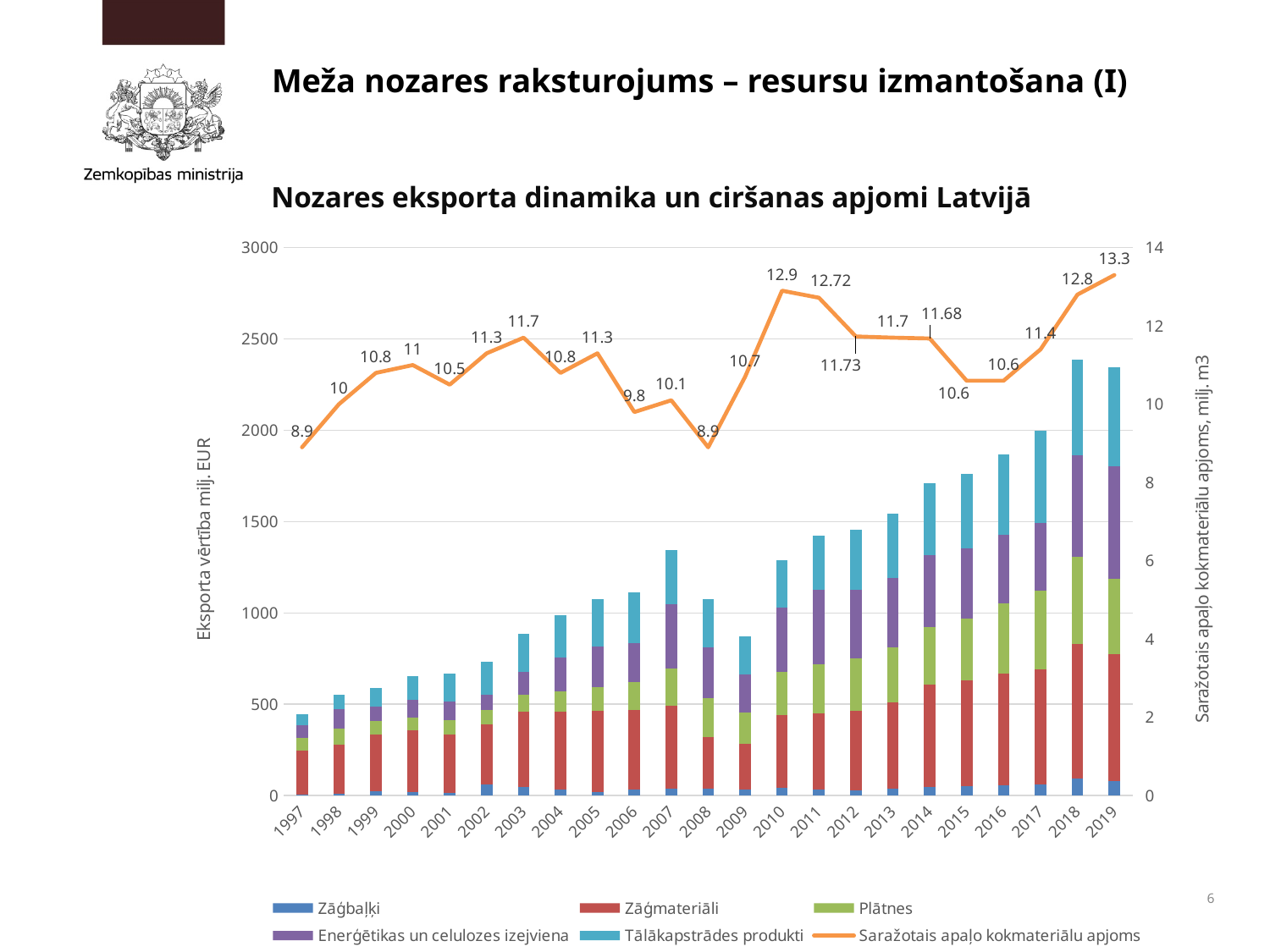
Is the total export value (stacked bar) for 1997 greater or less than 500? less How many years are shown on the x axis? 23 What is the value of Saražotais apaļo kokmateriālu apjoms for 2019? 13.3 Which year has the larger value of Saražotais apaļo kokmateriālu apjoms, 2010 or 2011? 2010 What is the difference between Saražotais apaļo kokmateriālu apjoms in 2019 and in 1997? 4.4 Is the total export value (stacked bar) for 2017 greater or less than 1500? greater How many series does the legend list? 6 What is the value of Saražotais apaļo kokmateriālu apjoms for 2001? 10.5 In which year is Saražotais apaļo kokmateriālu apjoms highest? 2019 What is the title of the chart? Nozares eksporta dinamika un ciršanas apjomi Latvijā What is the value of Saražotais apaļo kokmateriālu apjoms for 2011? 12.72 What kind of chart is this? Combined stacked bar and line chart